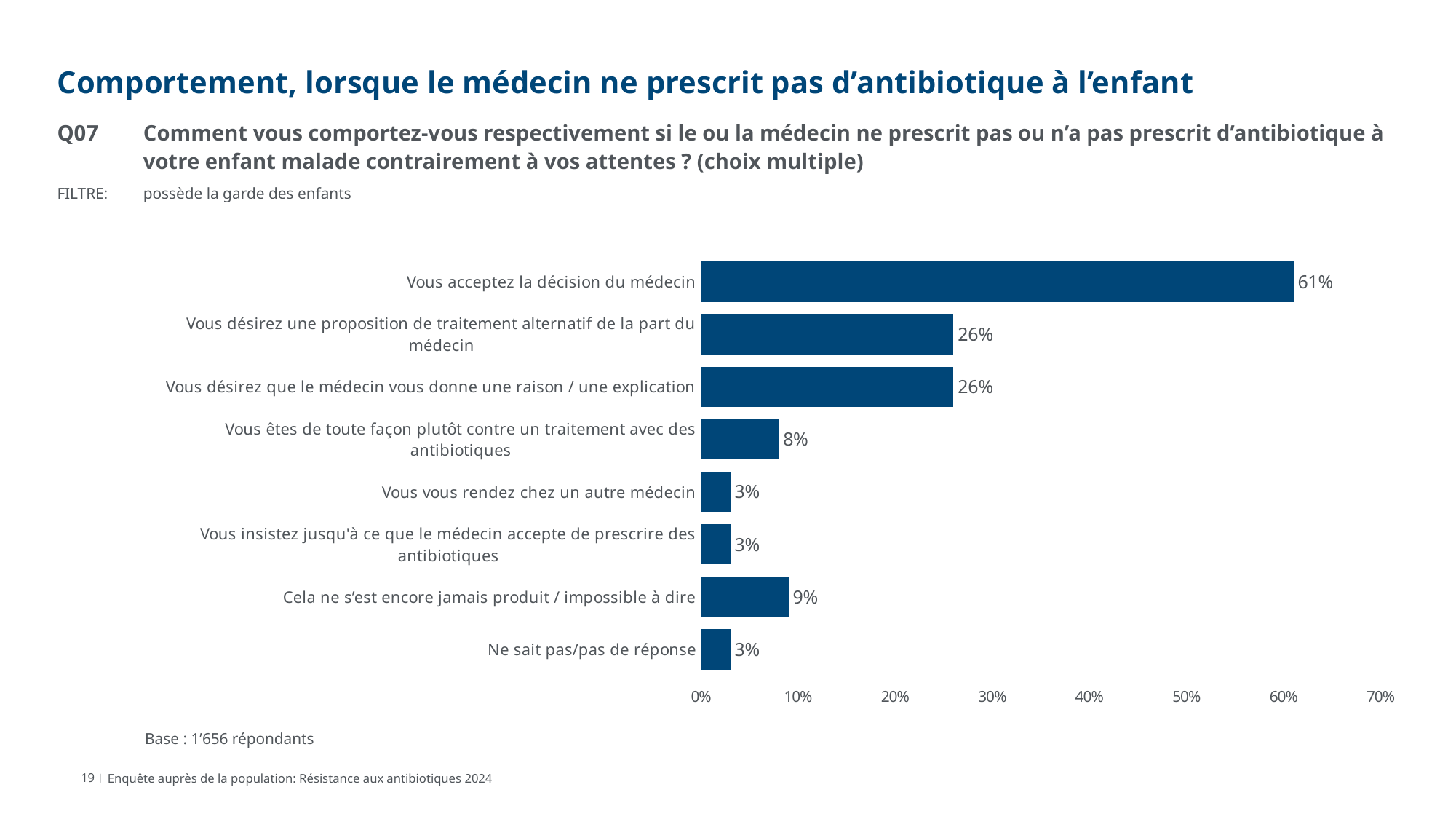
Which is larger: "Cela ne s'est encore jamais produit / impossible à dire" or "Vous êtes de toute façon plutôt contre un traitement avec des antibiotiques"? Cela ne s'est encore jamais produit / impossible à dire What is the value for "Cela ne s'est encore jamais produit / impossible à dire"? 9% How many categories are shown in the chart? 8 What is the difference between "Vous acceptez la décision du médecin" and "Vous désirez une proposition de traitement alternatif de la part du médecin"? 35 percentage points Is the value for "Vous acceptez la décision du médecin" greater or less than 50%? greater What is the value for "Vous acceptez la décision du médecin"? 61% What kind of chart is shown on the slide? Bar chart What is the value for "Vous êtes de toute façon plutôt contre un traitement avec des antibiotiques"? 8% What is the value for "Vous désirez que le médecin vous donne une raison / une explication"? 26% What is the highest tick value shown on the x axis? 70% What is the base number of respondents stated below the chart? 1'656 répondants Which category has the highest value? Vous acceptez la décision du médecin